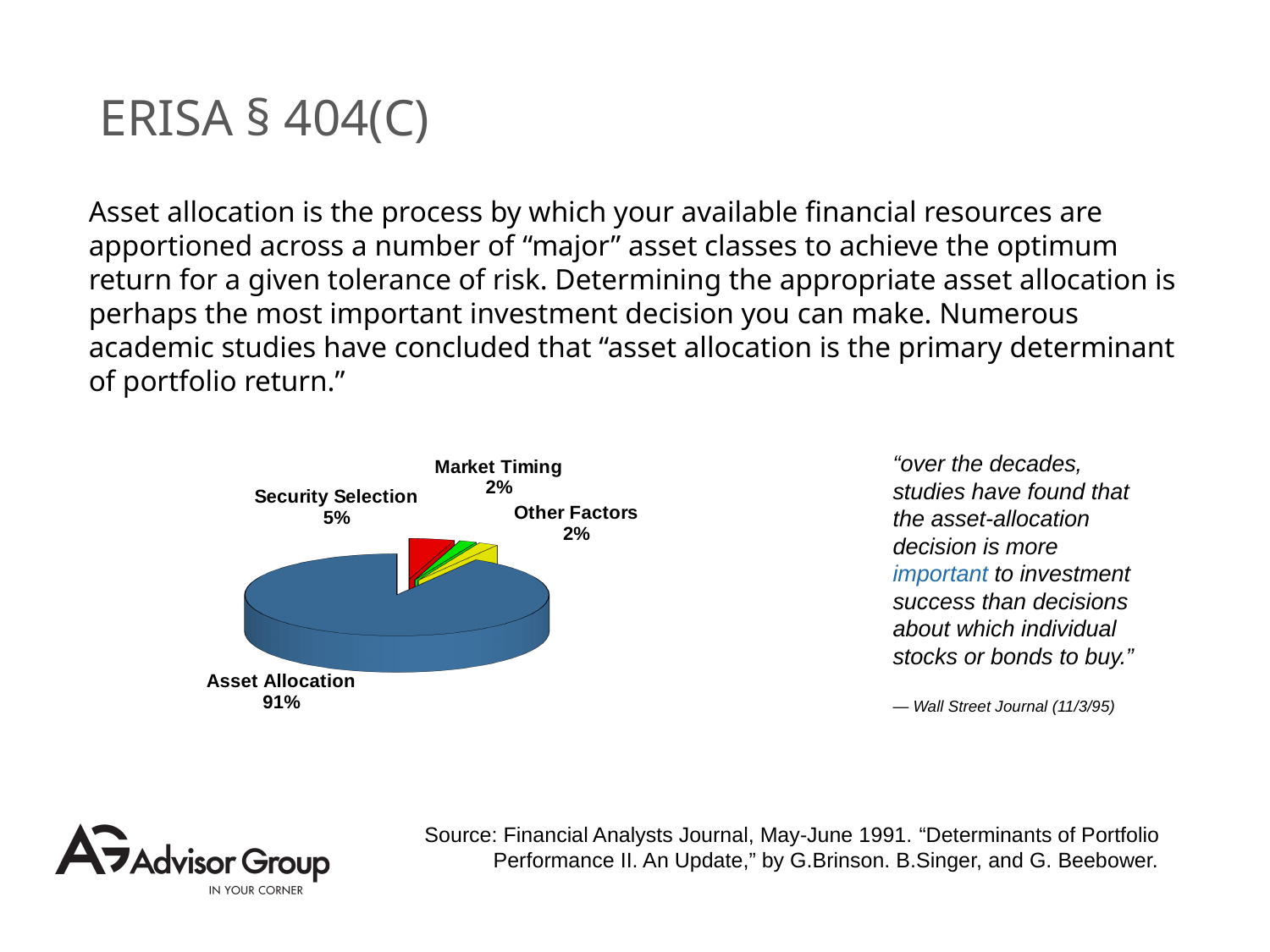
What is the difference between the Asset Allocation and Security Selection values? 86% What share of the pie does Asset Allocation account for? 91% Which is larger, Security Selection or Market Timing? Security Selection What is the value shown for Security Selection? 5% What colour is the Security Selection slice? red What kind of chart is shown on the slide? pie chart What colour is the Asset Allocation slice? blue What is the value shown for Market Timing? 2% How many slices does the pie chart have? 4 Which category has the largest slice of the pie? Asset Allocation What is the value shown for Other Factors? 2% What is the combined value of Security Selection, Market Timing and Other Factors? 9%